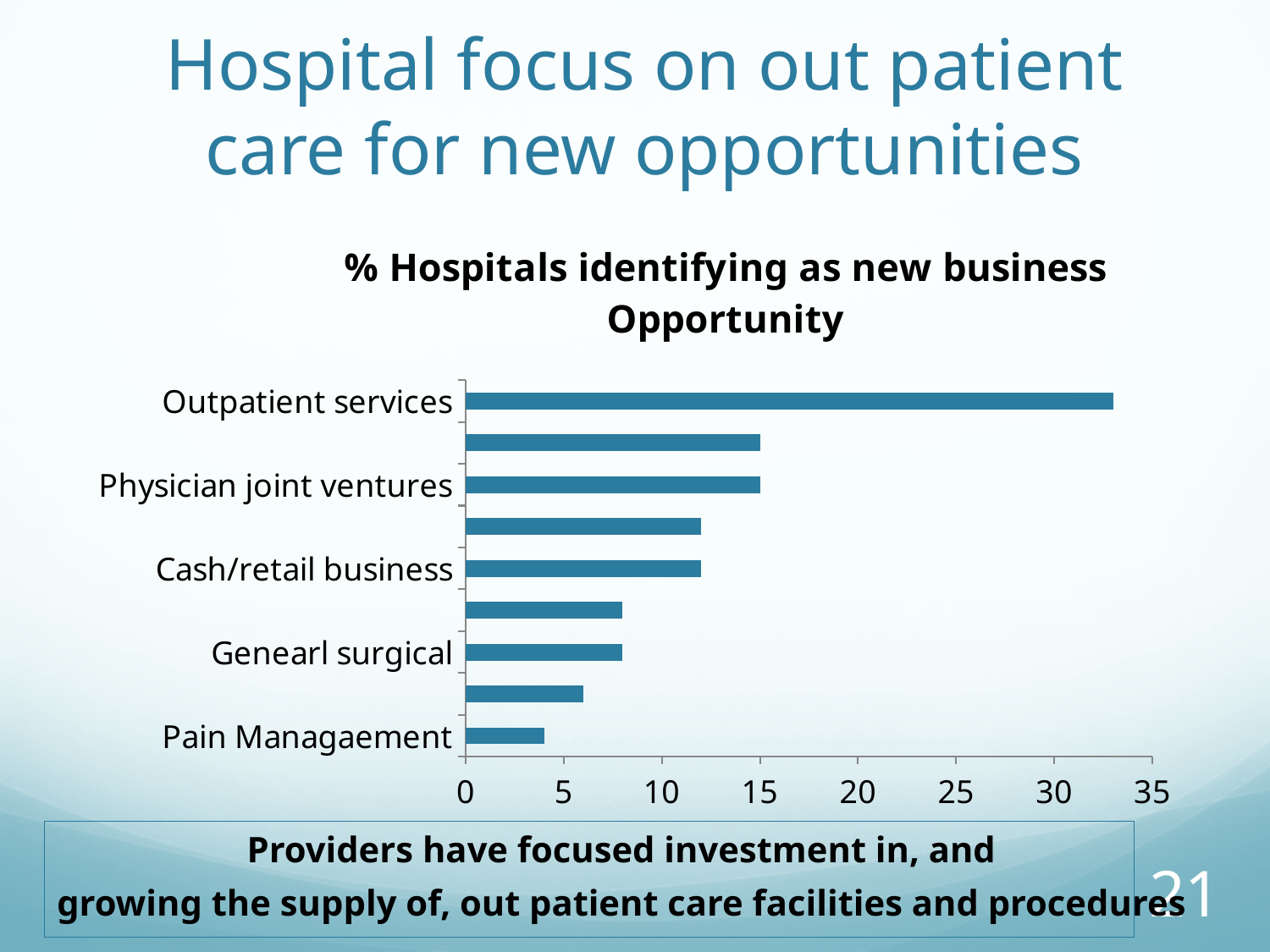
Which is larger, the value for Physician joint ventures or the value for Cash/retail business? Physician joint ventures What is the title of the chart? % Hospitals identifying as new business Opportunity Is the value for Pain Managaement greater or less than 5? less Is the value for Physician joint ventures greater or less than 20? less Which is larger, the value for Genearl surgical or the value for Pain Managaement? Genearl surgical Is the value for Outpatient services greater or less than 30? greater Which labelled category has the lowest value in the chart? Pain Managaement Which category has the highest value in the chart? Outpatient services What kind of chart is shown on the slide? bar chart How many bars are plotted in the chart? 9